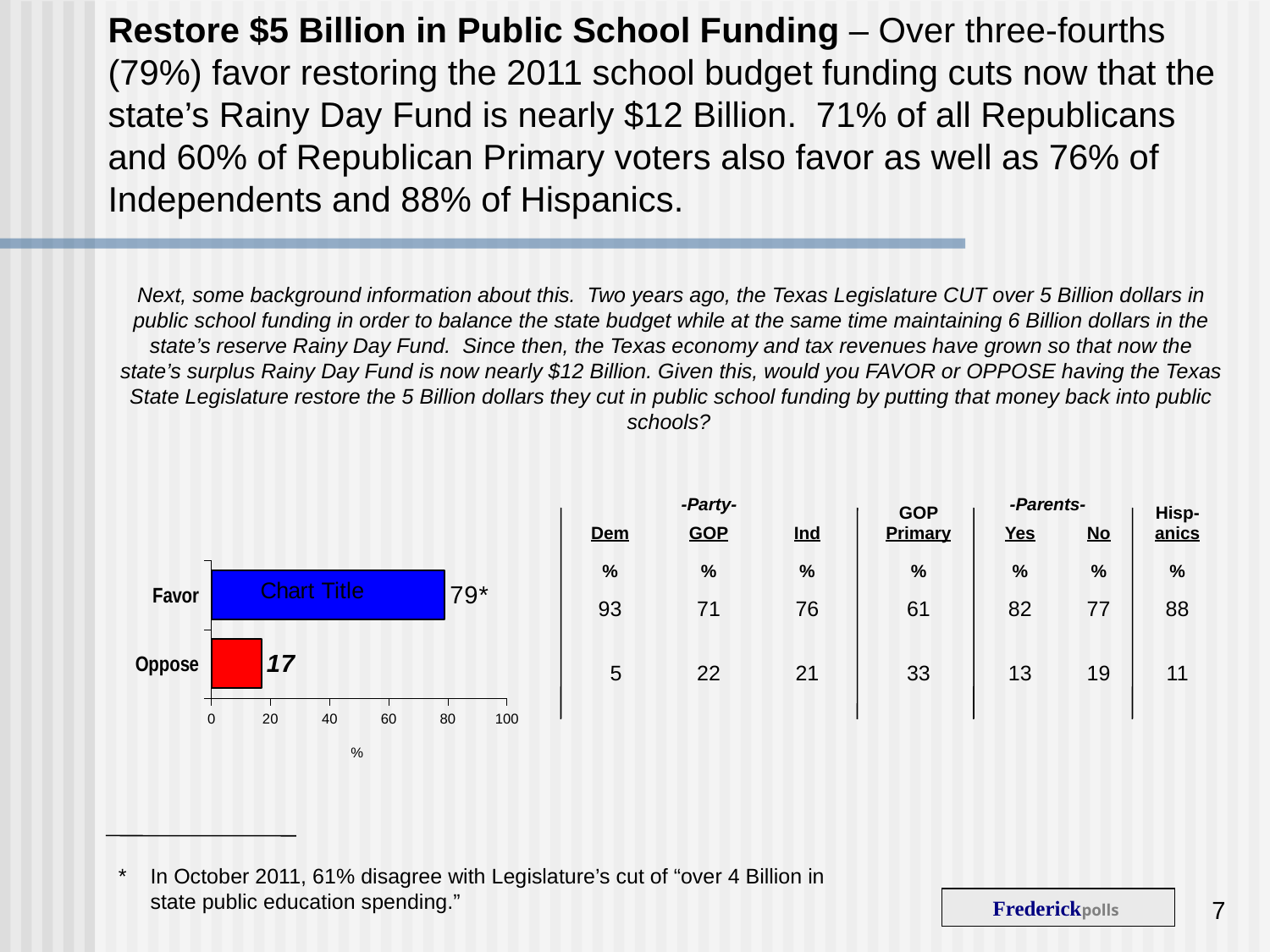
What is the difference between the Favor and Oppose values in the bar chart? 62 How many categories are shown in the bar chart? 2 What colour is the Favor bar in the chart? blue What is the value for Favor in the bar chart? 79 Which category has the highest value in the bar chart? Favor Is the value for Oppose greater or less than 40? less Which category has the lowest value in the bar chart? Oppose Which is larger in the bar chart, Favor or Oppose? Favor What is the maximum value shown on the horizontal axis of the bar chart? 100 What type of chart is shown on the slide? bar chart Is the value for Favor greater or less than 60? greater What is the value for Oppose in the bar chart? 17